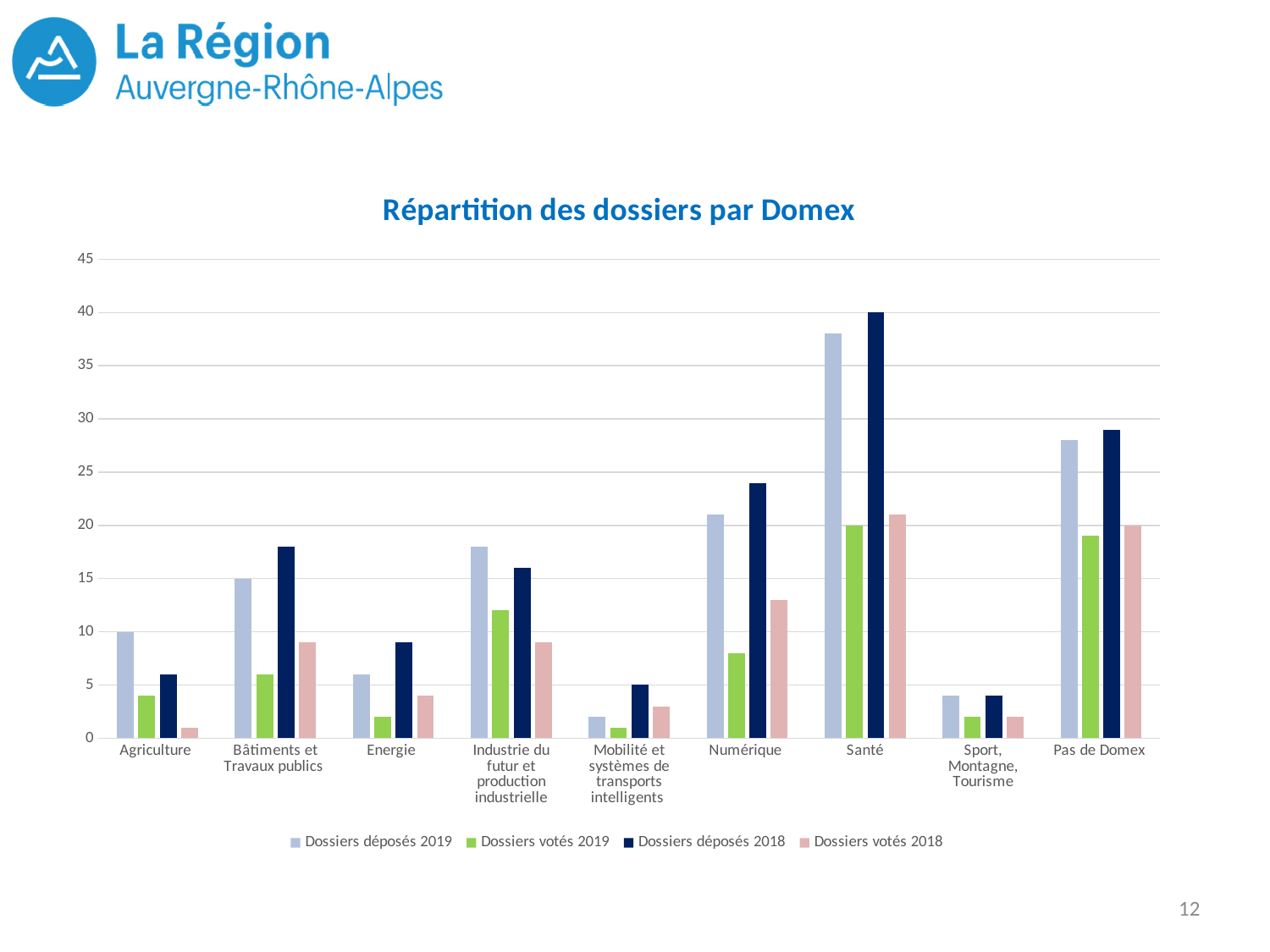
Which category has the lowest value for Dossiers déposés 2019? Mobilité et systèmes de transports intelligents Is the value of Dossiers déposés 2019 for Santé greater or less than 35? greater What is the value of Dossiers déposés 2019 for Agriculture? 10 Is the value of Dossiers votés 2019 for Energie greater or less than 5? less What is the value of Dossiers déposés 2018 for Santé? 40 What is the title of the chart? Répartition des dossiers par Domex Which category has the highest value for Dossiers déposés 2018? Santé Which is larger for Dossiers déposés 2018: Santé or Pas de Domex? Santé How many series does the legend list? 4 Is the value of Dossiers déposés 2018 for Numérique greater or less than 20? greater How many categories are shown on the x axis? 9 What type of chart is shown on the slide? bar chart